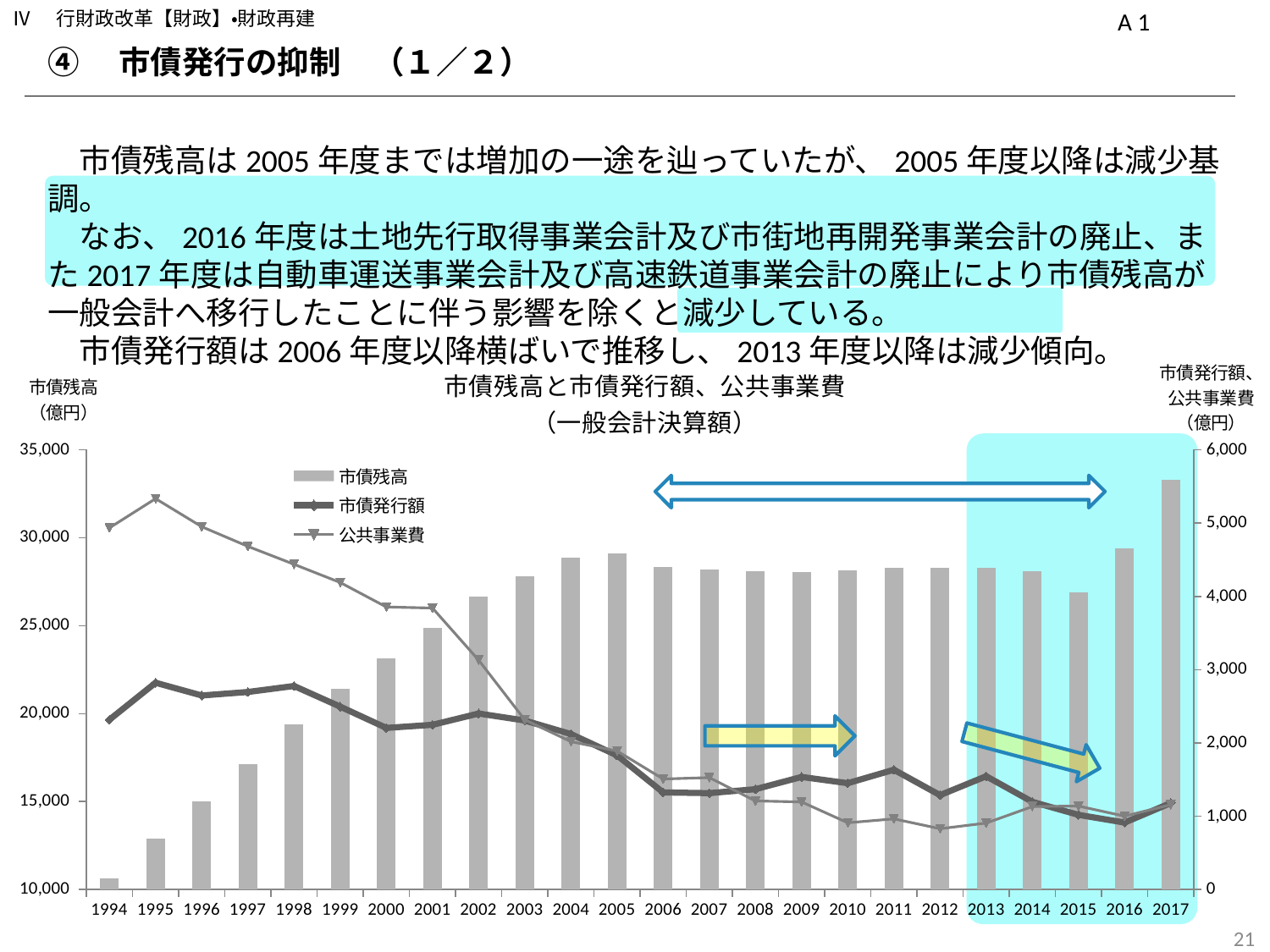
Which year has the lowest 市債残高 bar? 1994 How many series does the legend list? 3 Which series is plotted as bars? 市債残高 Is the 公共事業費 value for 1995 greater or less than 5,000? greater Which year has the highest 市債残高 bar? 2017 Does the 公共事業費 line generally rise or fall from 1994 to 2017? fall Is the 市債発行額 value for 2017 greater or less than 2,000? less Is the 市債残高 value for 1994 greater or less than 15,000? less How many years are shown on the x axis? 24 Which year has the highest value for 公共事業費? 1995 What kind of chart is shown on the slide? A combined bar and line chart